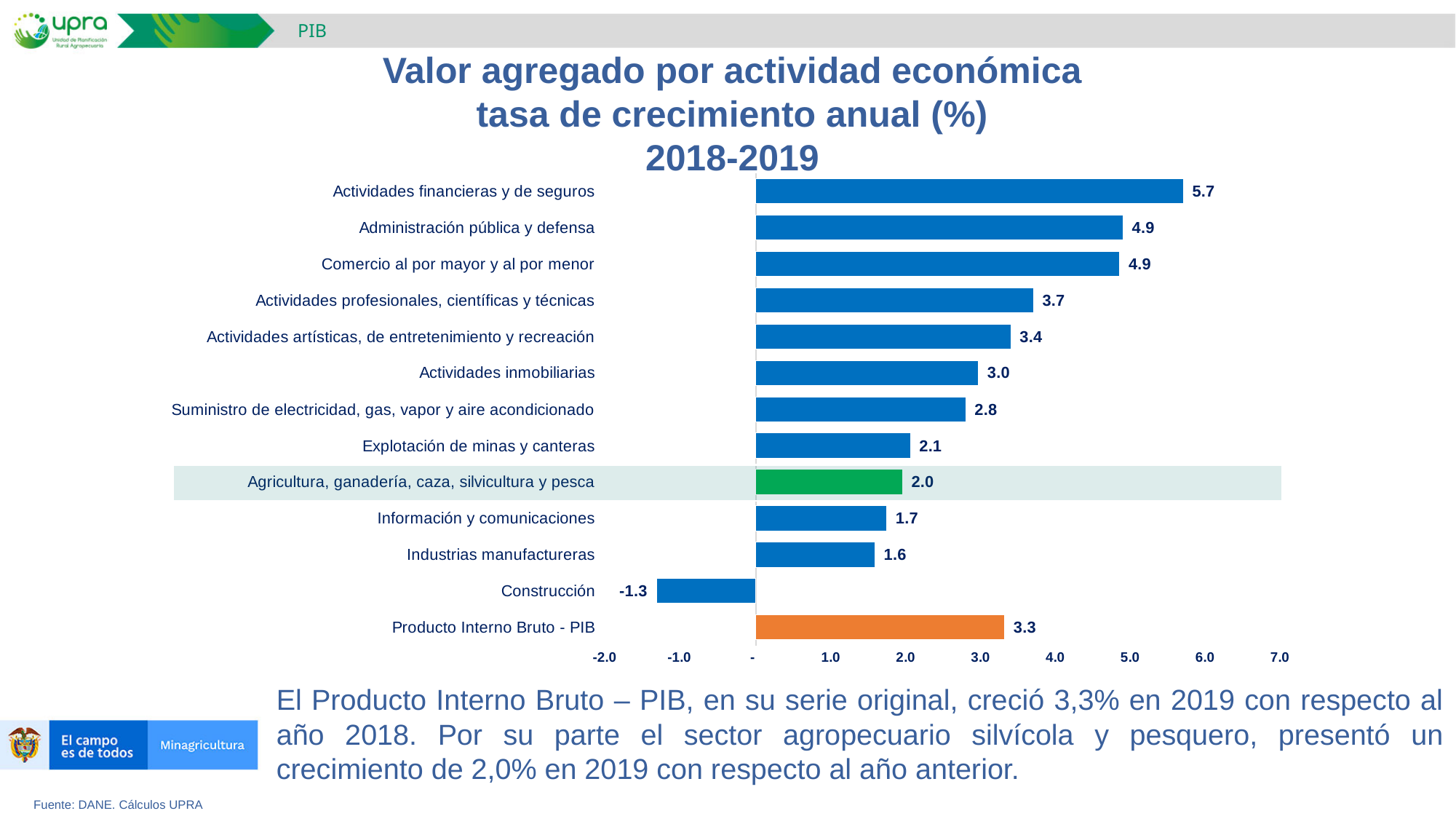
What is the difference between the values for Actividades profesionales, científicas y técnicas and Industrias manufactureras? 2.1 Which category has the highest growth rate in the chart? Actividades financieras y de seguros What value is shown for Construcción? -1.3 What is the annual growth rate shown for Actividades financieras y de seguros? 5.7 What is the growth rate shown for Producto Interno Bruto - PIB? 3.3 What is the difference between the values for Actividades financieras y de seguros and Producto Interno Bruto - PIB? 2.4 How many categories are plotted in the chart? 13 What value is shown for Agricultura, ganadería, caza, silvicultura y pesca? 2.0 What kind of chart is shown on the slide? Bar chart Which is larger, the value for Actividades inmobiliarias or the value for Explotación de minas y canteras? Actividades inmobiliarias Which bar in the chart is coloured orange? Producto Interno Bruto - PIB Which category has the lowest growth rate in the chart? Construcción